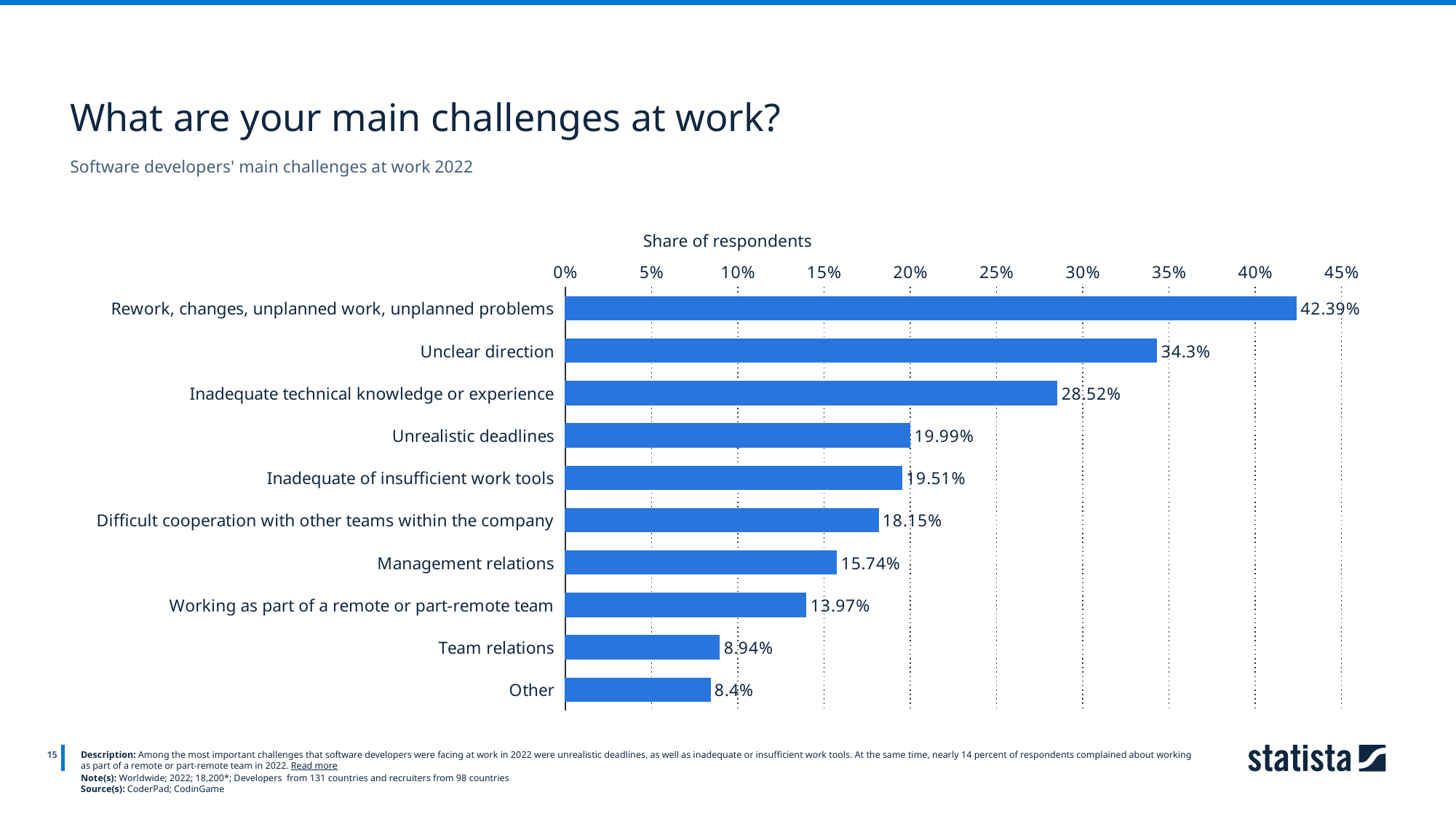
What is the value for 'Working as part of a remote or part-remote team'? 13.97% What kind of chart is shown on the slide? Bar chart Is the value for 'Difficult cooperation with other teams within the company' greater or less than 20%? less What share of respondents cited management relations? 15.74% Which challenge has the highest share of respondents? Rework, changes, unplanned work, unplanned problems Which category has the lowest share of respondents? Other What is the difference between the shares for 'Unrealistic deadlines' and 'Inadequate of insufficient work tools'? 0.48% Which has a larger share of respondents: 'Team relations' or 'Management relations'? Management relations What is the label of the horizontal axis? Share of respondents What share of respondents cited unclear direction as a main challenge at work? 34.3% How many challenge categories are shown in the chart? 10 What is the difference between the shares for 'Unclear direction' and 'Inadequate technical knowledge or experience'? 5.78%